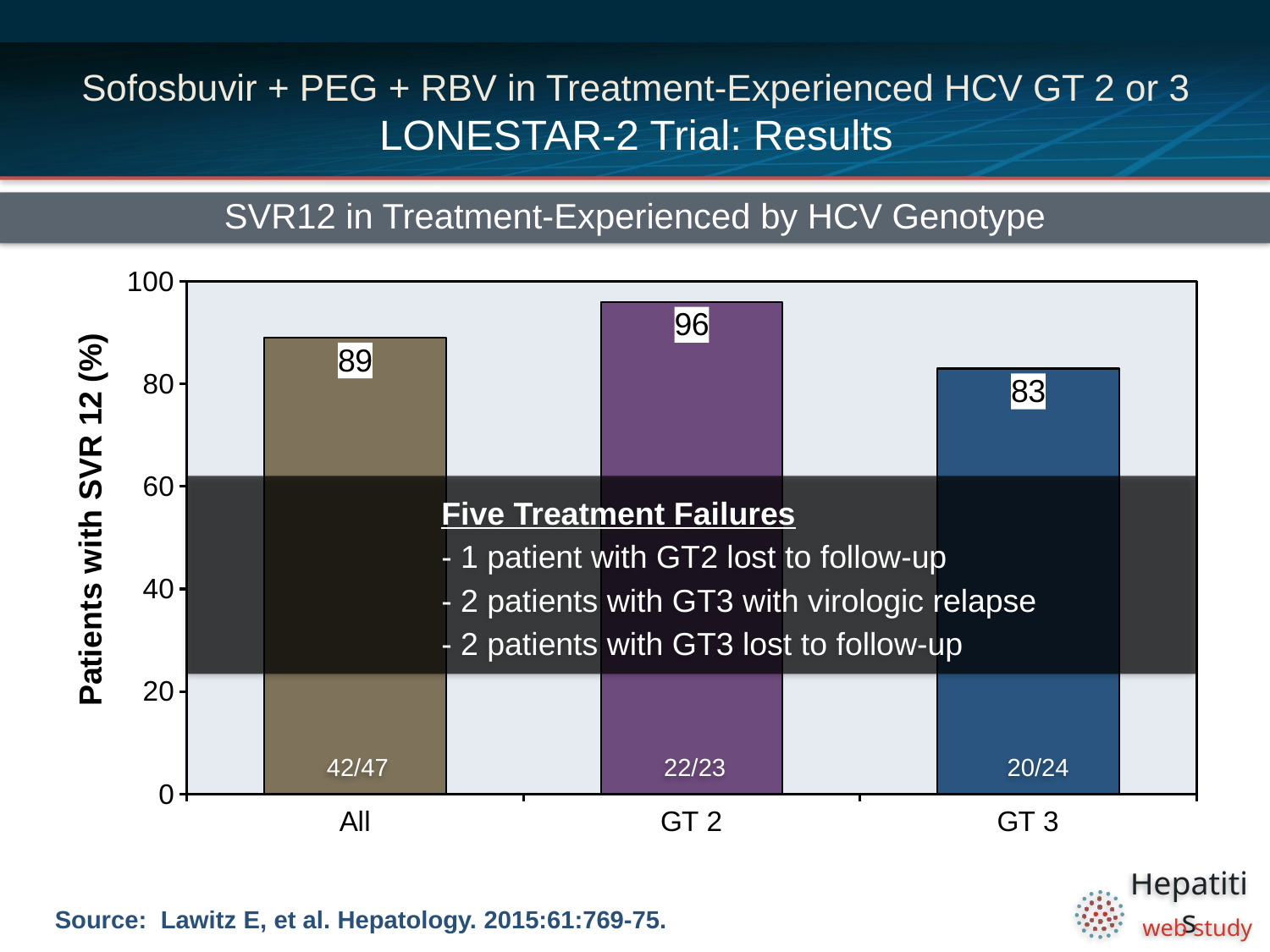
Which group has the lowest SVR12 rate? GT 3 What is the SVR12 rate for the All group? 89 Which has a higher SVR12 rate, All or GT 3? All Which genotype group has the highest SVR12 rate? GT 2 How many patients achieved SVR12 in the GT 2 group, as shown by the fraction on the bar? 22/23 What type of chart is shown on the slide? Bar chart What is the SVR12 rate for GT 3? 83 What fraction is shown on the GT 3 bar? 20/24 How many categories are shown on the x axis? 3 What is the SVR12 rate for GT 2? 96 What is the difference in SVR12 rate between GT 2 and GT 3? 13 What is the y-axis label of the chart? Patients with SVR 12 (%)